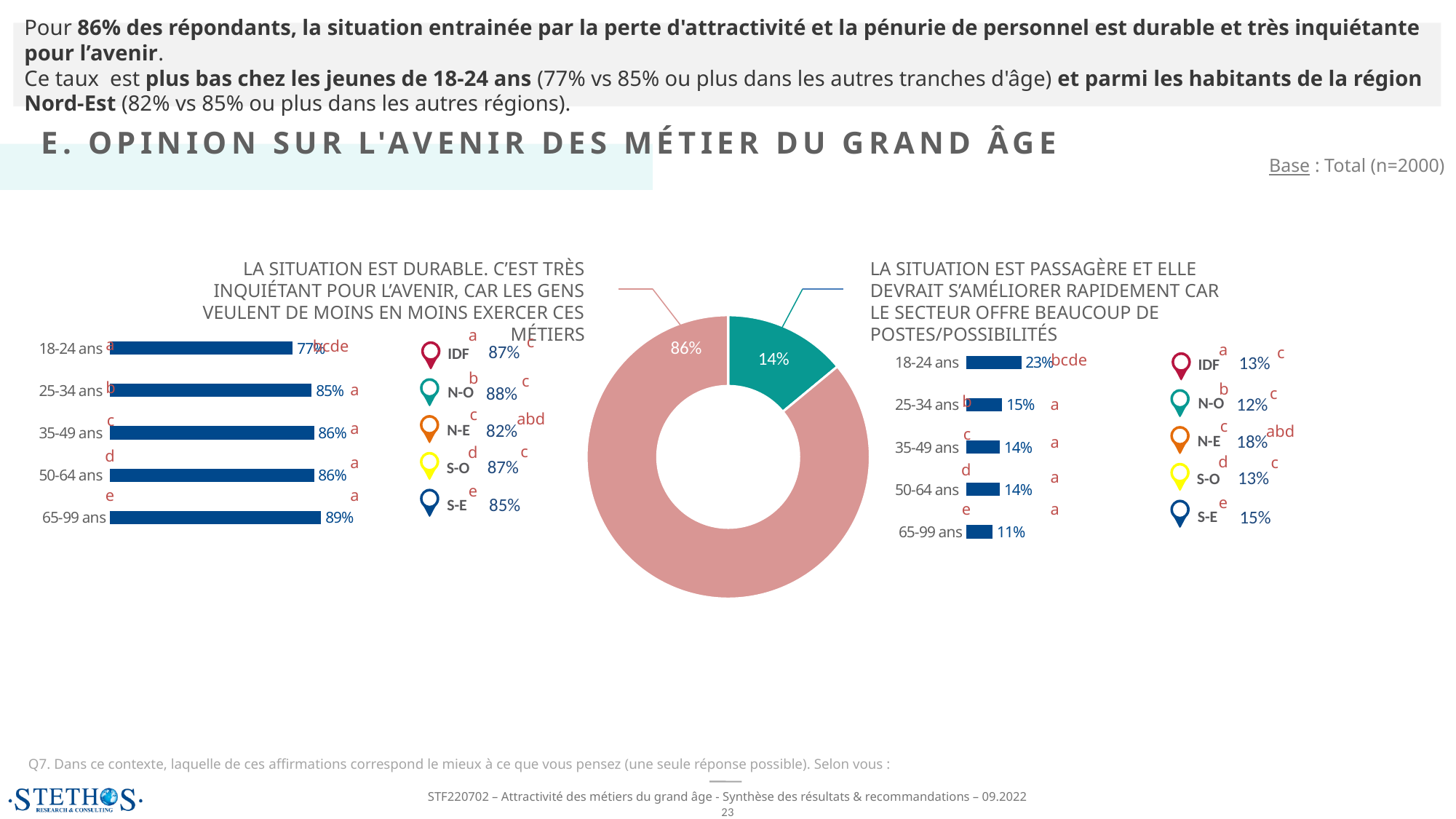
In the left bar chart (situation durable), which age group has the highest value? 65-99 ans What kind of chart is used to show the values by age group on the left and right of the slide? Bar chart In the left bar chart (situation durable), what is the value for 18-24 ans? 77% In the central donut chart, what share of respondents say the situation is temporary and should improve quickly? 14% In the right bar chart (situation passagère), what is the value for 18-24 ans? 23% In the central donut chart, what share of respondents say the situation is durable and very worrying for the future? 86% In the left bar chart (situation durable), what is the difference between the values for 65-99 ans and 18-24 ans? 12 percentage points In the right bar chart (situation passagère), is the value for 25-34 ans or 65-99 ans larger? 25-34 ans What kind of chart is the central chart showing 86% and 14%? Donut (pie) chart In the left bar chart (situation durable), which age group has the lowest value? 18-24 ans In the right bar chart (situation passagère), which age group has the lowest value? 65-99 ans How many age groups are shown in the left bar chart (situation durable)? 5